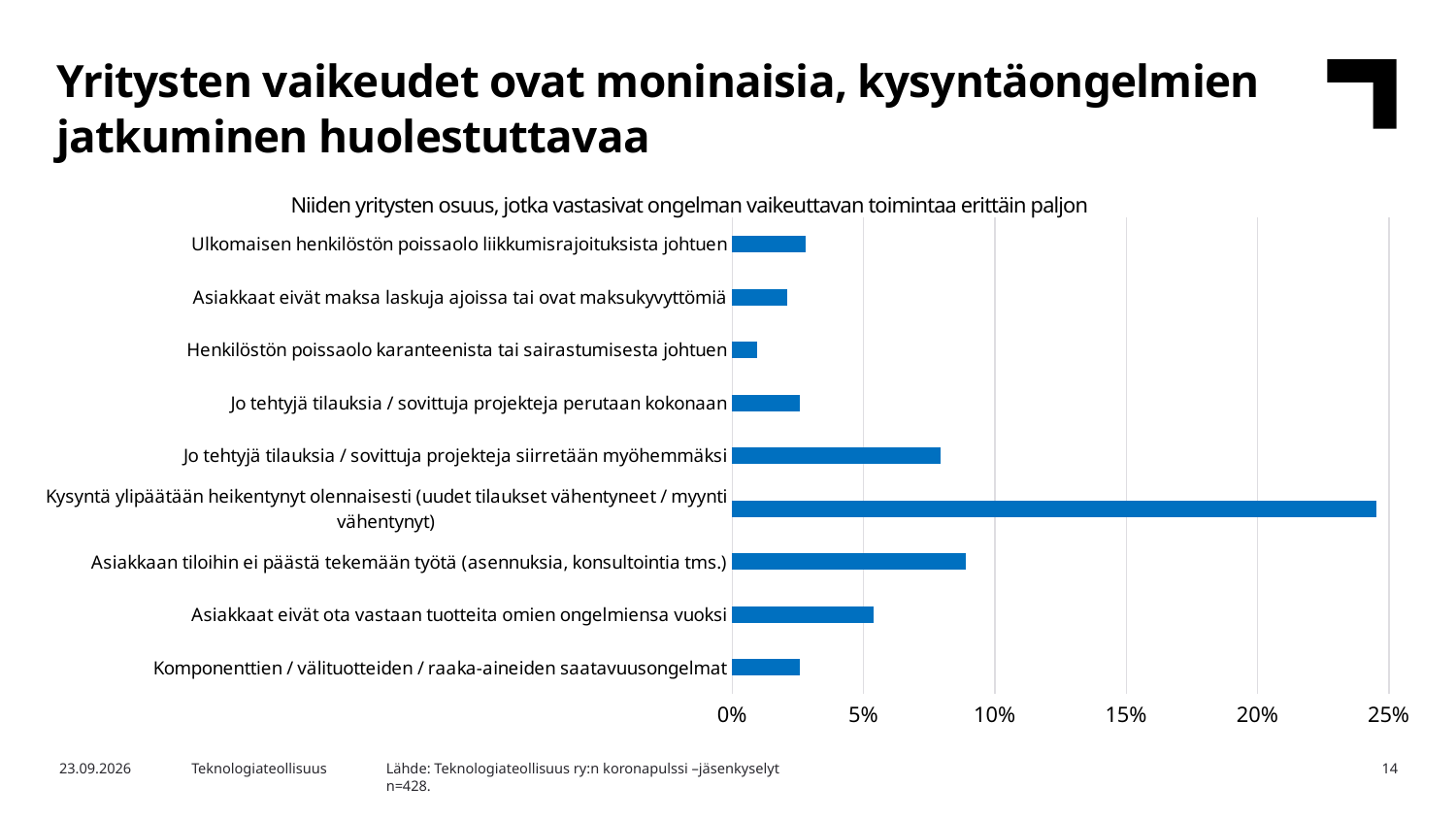
Which category has the highest value in the chart? Kysyntä ylipäätään heikentynyt olennaisesti (uudet tilaukset vähentyneet / myynti vähentynyt) How many categories are plotted in the chart? 9 What is the title of the chart? Niiden yritysten osuus, jotka vastasivat ongelman vaikeuttavan toimintaa erittäin paljon Which category has the lowest value in the chart? Henkilöstön poissaolo karanteenista tai sairastumisesta johtuen Is the value for 'Asiakkaan tiloihin ei päästä tekemään työtä' greater or less than 10%? less What kind of chart is shown on the slide? bar chart Which is larger: the value for 'Jo tehtyjä tilauksia / sovittuja projekteja siirretään myöhemmäksi' or the value for 'Jo tehtyjä tilauksia / sovittuja projekteja perutaan kokonaan'? Jo tehtyjä tilauksia / sovittuja projekteja siirretään myöhemmäksi Is the value for 'Henkilöstön poissaolo karanteenista tai sairastumisesta johtuen' greater or less than 5%? less Which is larger: the value for 'Asiakkaan tiloihin ei päästä tekemään työtä' or the value for 'Asiakkaat eivät ota vastaan tuotteita omien ongelmiensa vuoksi'? Asiakkaan tiloihin ei päästä tekemään työtä Is the value for 'Kysyntä ylipäätään heikentynyt olennaisesti' greater or less than 20%? greater